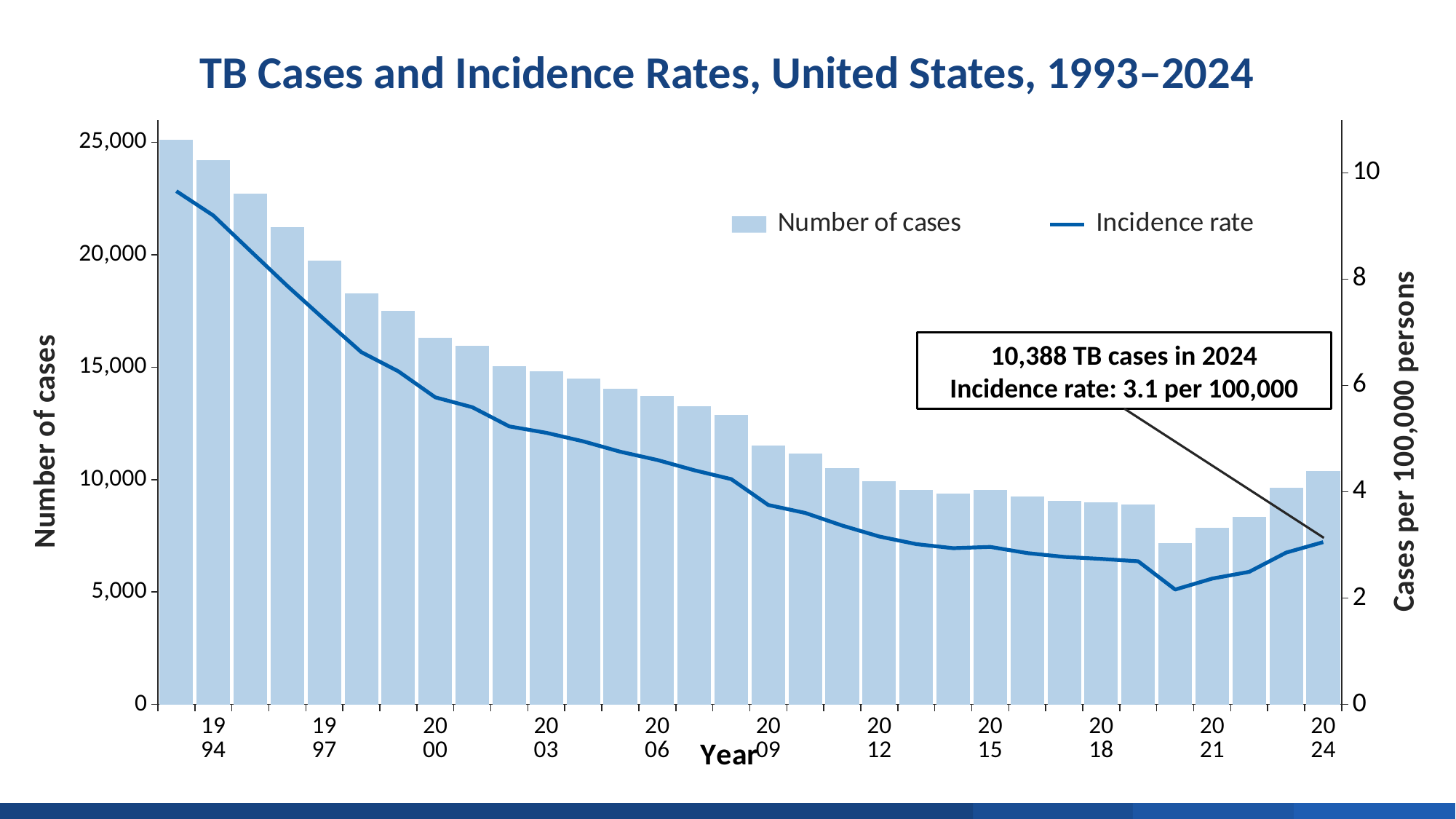
How many TB cases were reported in 2024? 10,388 Is the number of cases in 2021 greater or less than 10,000? less Which year has more TB cases, 2021 or 2024? 2024 Is the incidence rate in 2012 greater or less than 4 per 100,000? less What is the title of the chart? TB Cases and Incidence Rates, United States, 1993–2024 Does the number of TB cases rise or fall from 1994 to 2018? Fall What are the two series named in the legend? Number of cases and Incidence rate What kind of chart is shown? A bar chart combined with a line chart Is the number of cases in 1994 greater or less than 20,000? greater How many years (bars) are plotted on the chart? 32 How many series does the legend list? 2 What was the TB incidence rate in 2024? 3.1 per 100,000